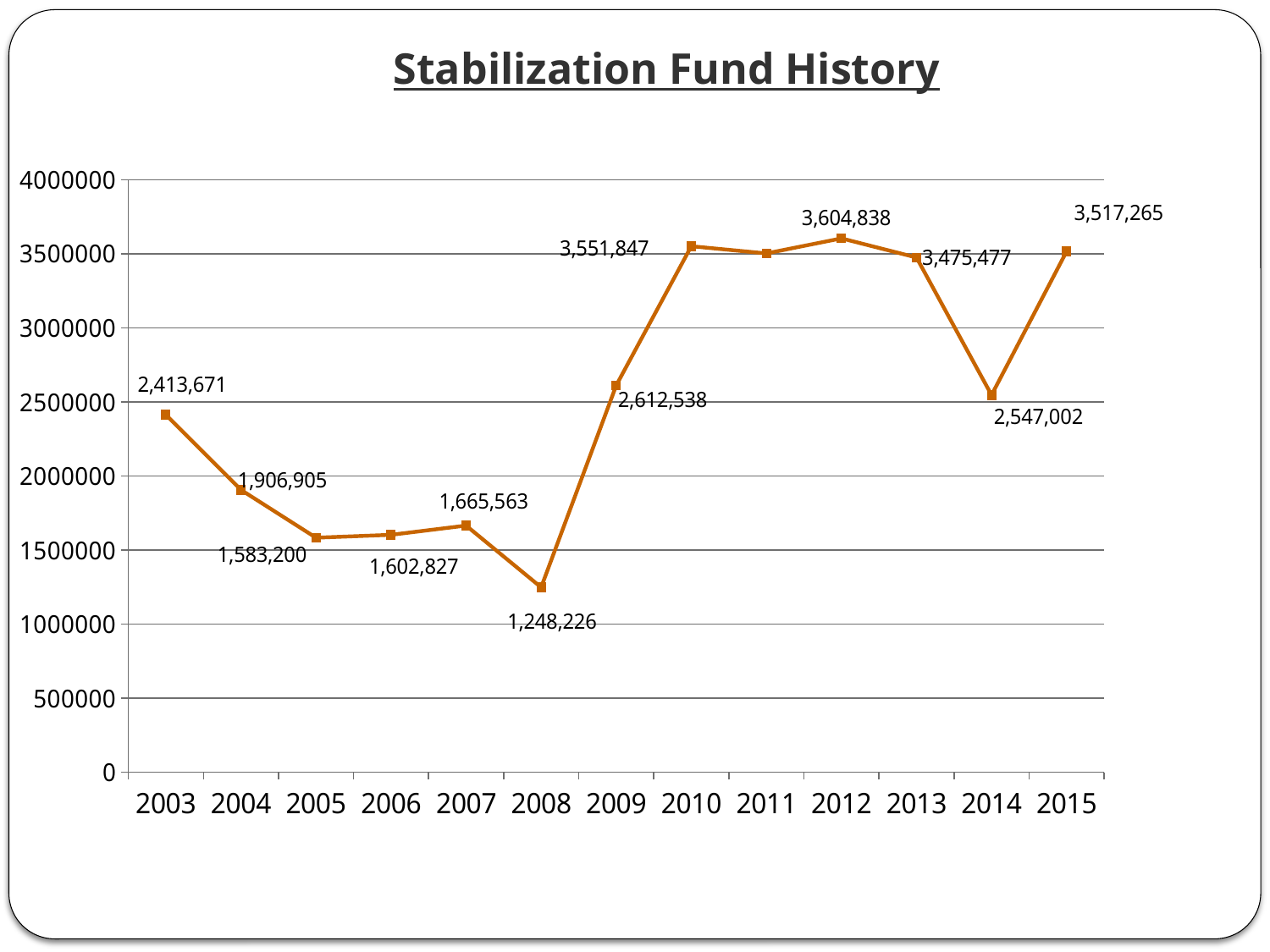
Which year has the highest value in the Stabilization Fund History chart? 2012 What is the value for 2012 in the Stabilization Fund History chart? 3,604,838 What kind of chart is shown on the slide? line chart Which year has the lowest value in the Stabilization Fund History chart? 2008 What is the difference between the values for 2012 and 2008? 2,356,612 What is the difference between the values for 2015 and 2014? 970,263 How many years are plotted on the x axis of the chart? 13 What is the value for 2008 in the Stabilization Fund History chart? 1,248,226 Which year has a larger value, 2009 or 2010? 2010 What is the value for 2014 in the Stabilization Fund History chart? 2,547,002 Is the value for 2011 greater or less than 3000000? greater What is the value for 2003 in the Stabilization Fund History chart? 2,413,671